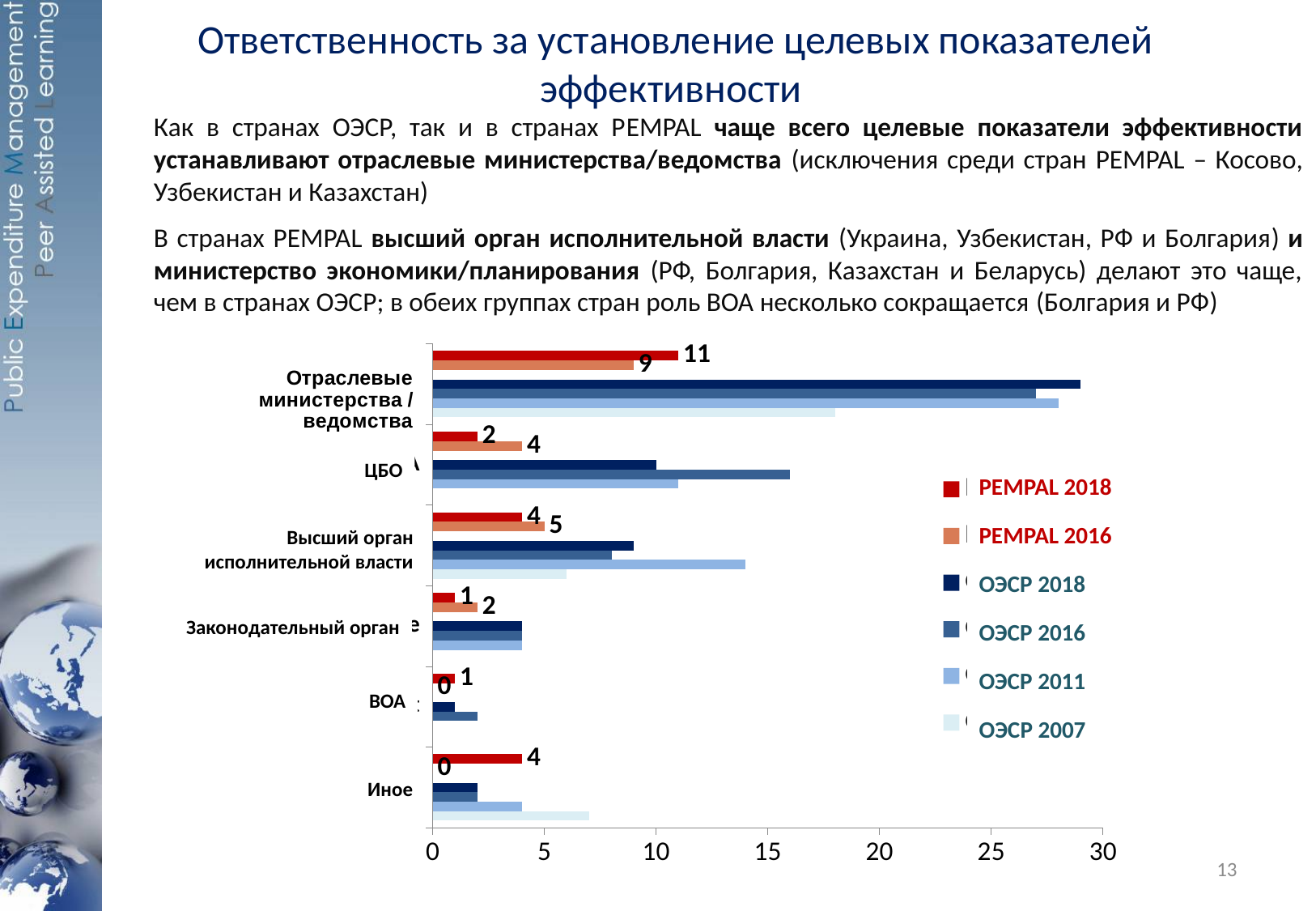
What is the PEMPAL 2016 value for Отраслевые министерства / ведомства? 9 Is the ОЭСР 2007 value for Иное greater or less than 5? greater Which category has the highest PEMPAL 2018 value? Отраслевые министерства / ведомства For Высший орган исполнительной власти, which is larger: the PEMPAL 2018 value or the PEMPAL 2016 value? PEMPAL 2016 What is the PEMPAL 2018 value for Иное? 4 How many categories are shown on the vertical axis of the chart? 6 What kind of chart is shown on the slide? bar chart How many series does the legend list? 6 What is the PEMPAL 2016 value for ЦБО? 4 Is the ОЭСР 2018 value for Отраслевые министерства / ведомства greater or less than 25? greater What is the difference between the PEMPAL 2018 and PEMPAL 2016 values for Отраслевые министерства / ведомства? 2 What is the PEMPAL 2018 value for Отраслевые министерства / ведомства? 11